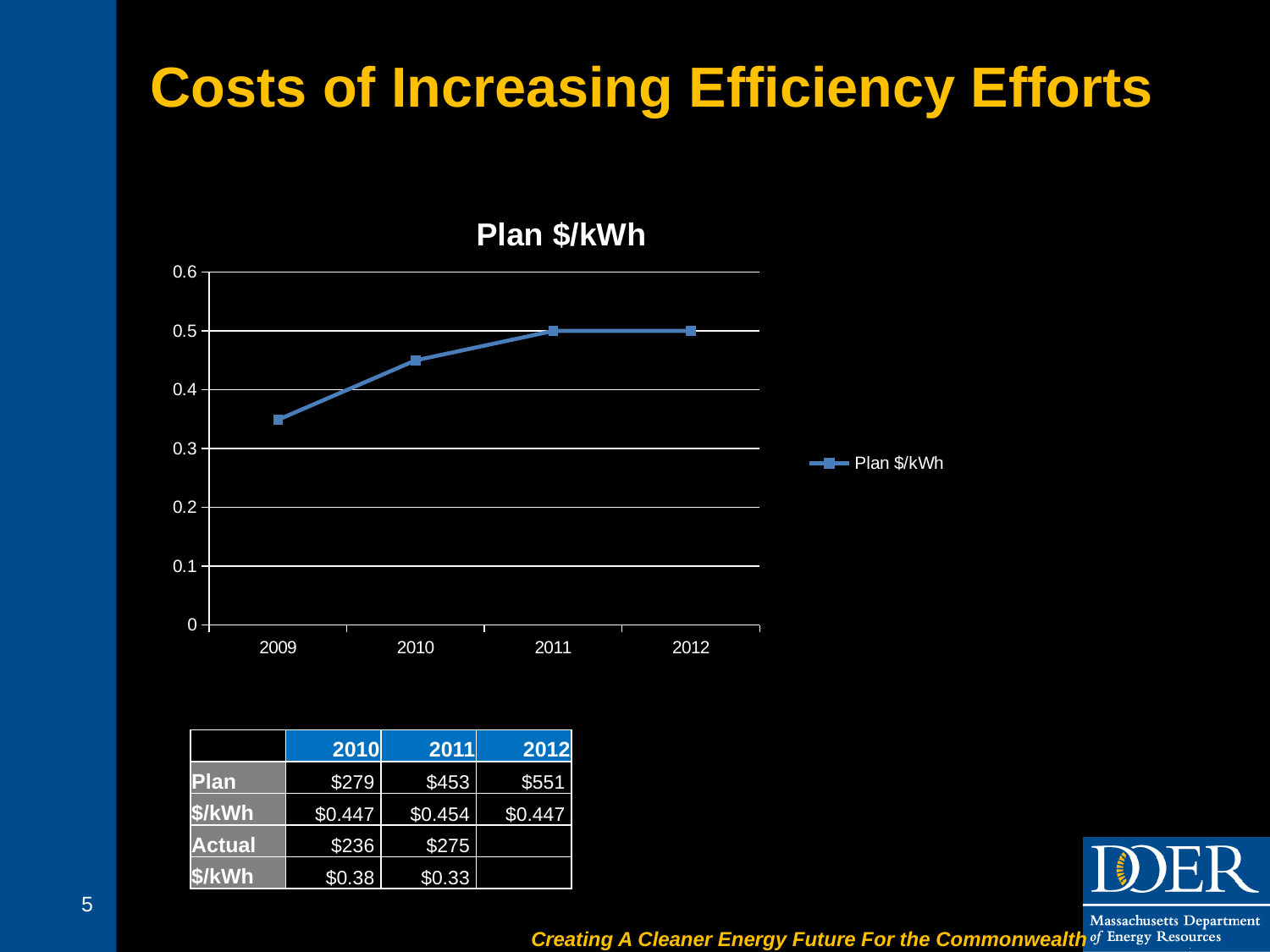
Which year has the lowest Plan $/kWh value? 2009 Which is larger, the value for 2010 or the value for 2011? 2011 Is the value for 2009 greater or less than 0.3? greater How many years are plotted along the x axis of the chart? 4 Is the value for 2010 greater or less than 0.4? greater Which is larger, the value for 2009 or the value for 2010? 2010 What is the title of the chart? Plan $/kWh How many series does the chart's legend list? 1 Is the value for 2009 greater or less than 0.4? less Do the plotted values rise or fall from 2009 to 2011? rise What kind of chart is shown on the slide? line chart